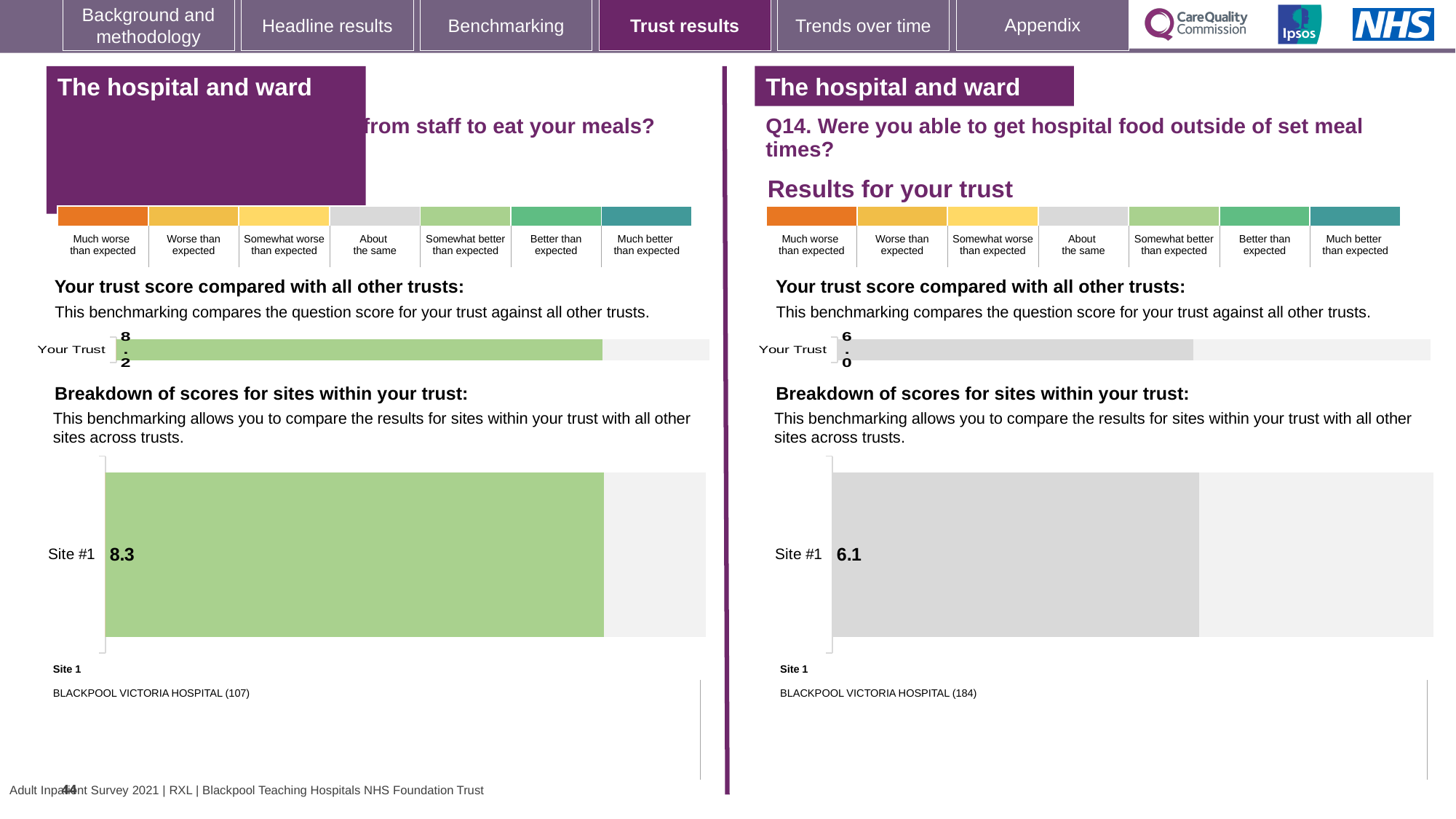
What kind of chart is used to show the Site #1 score on the right-hand Q14 side? Bar chart On the right-hand Q14 side, how many respondents are shown in brackets for Blackpool Victoria Hospital (Site 1)? 184 On the right-hand Q14 chart, what is the score shown for Your Trust? 6.0 On the right-hand Q14 breakdown chart, what is the score for Site #1? 6.1 How many sites are shown in the breakdown chart on the right-hand Q14 side? 1 What colour is the Site #1 bar on the right-hand Q14 breakdown chart? Grey On the right-hand Q14 side, what is the difference between the Site #1 score and the Your Trust score? 0.1 On the left-hand trust score chart, what is the score shown for Your Trust? 8.2 On the left-hand breakdown chart, what is the score for Site #1? 8.3 Which Site #1 score is larger: the one on the left-hand chart or the one on the right-hand Q14 chart? Left-hand chart (8.3) What is the difference between the Site #1 score on the left-hand chart and the Site #1 score on the right-hand Q14 chart? 2.2 What colour is the Site #1 bar on the left-hand breakdown chart? Green